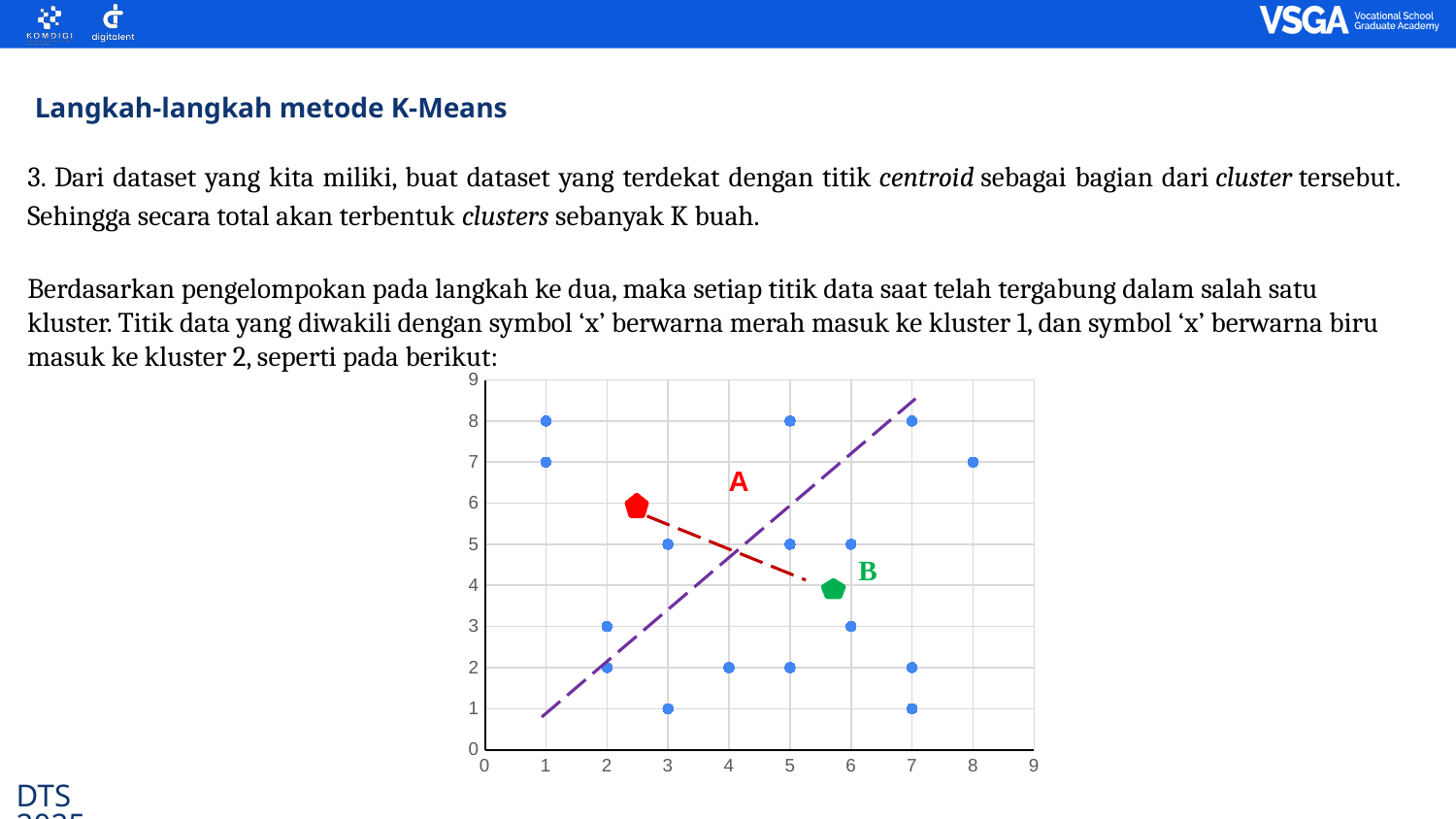
How many blue data points are plotted on the chart? 16 What is the highest value shown on the y axis of the chart? 9 Which centroid has the larger y value, the red pentagon A or the green pentagon B? A What letter labels the red pentagon centroid on the chart? A Is the y value of the green pentagon B greater or less than 5? less What kind of chart is shown on the slide? scatter plot What is the smallest y value among the blue data points on the chart? 1 How many blue data points lie on the line y = 8? 3 What is the largest x value among the blue data points on the chart? 8 How many blue data points lie on the line y = 2? 4 What is the y value of the blue data point plotted at x = 8? 7